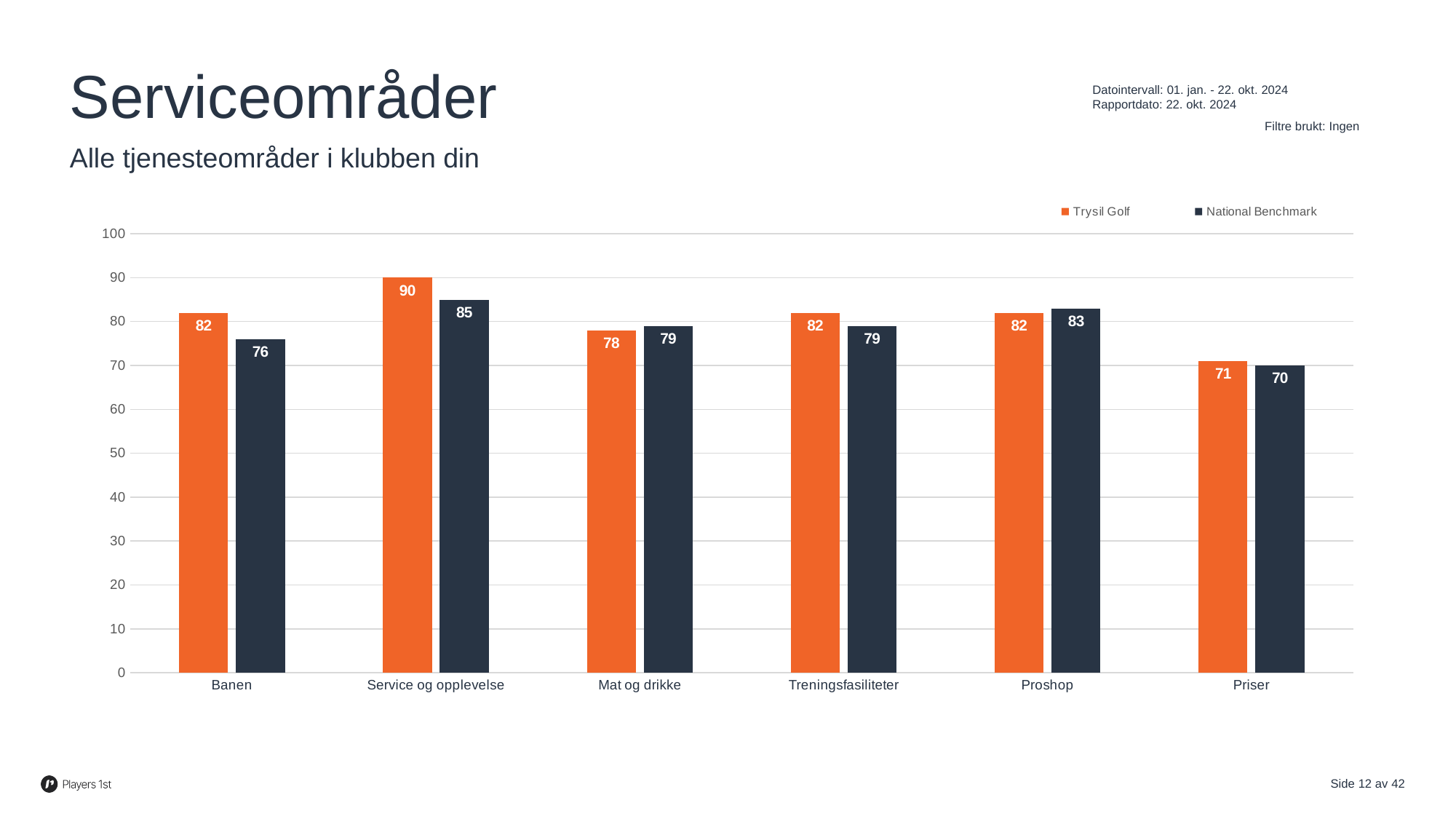
How many series does the legend list? 2 Which series is shown in orange? Trysil Golf Which category has the lowest National Benchmark value? Priser How many categories are shown on the x axis? 6 What is the Trysil Golf value for Priser? 71 For Proshop, which is larger: Trysil Golf or National Benchmark? National Benchmark What is the National Benchmark value for Service og opplevelse? 85 Which category has the highest Trysil Golf value? Service og opplevelse Is the Trysil Golf value for Mat og drikke greater or less than 70? greater What is the Trysil Golf value for Banen? 82 What is the difference between the Trysil Golf and National Benchmark values for Banen? 6 What kind of chart is shown on the slide? Bar chart